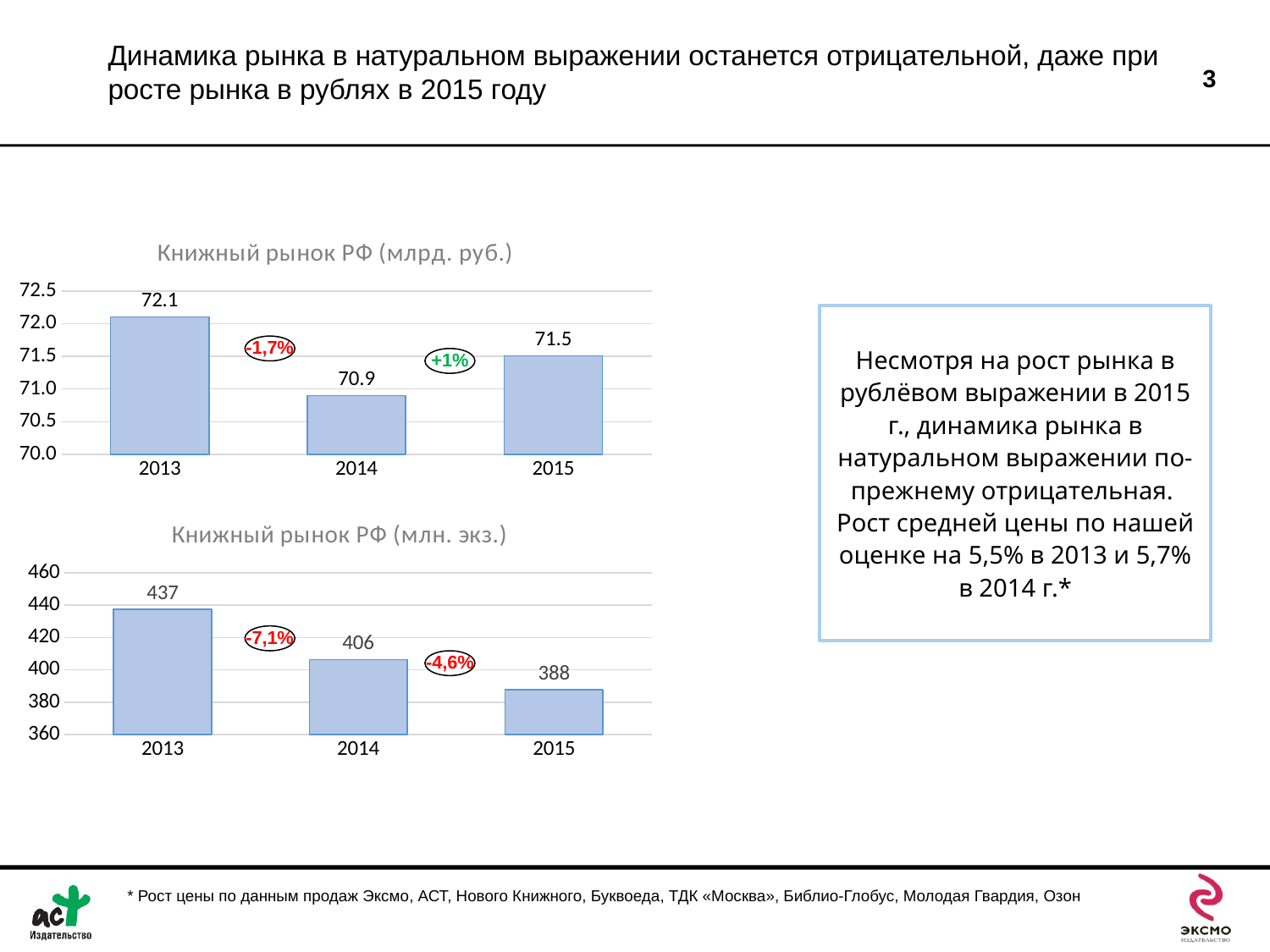
What kind of chart is the top chart on the slide? bar chart In the chart titled 'Книжный рынок РФ (млрд. руб.)', what is the difference between the 2013 and 2014 values? 1.2 In the chart titled 'Книжный рынок РФ (млрд. руб.)', what is the value for 2014? 70.9 In the chart titled 'Книжный рынок РФ (млрд. руб.)', which year has the lowest value? 2014 In the chart titled 'Книжный рынок РФ (млн. экз.)', which year has the lowest value? 2015 In the chart titled 'Книжный рынок РФ (млн. экз.)', what is the difference between the 2013 and 2015 values? 49 In the chart titled 'Книжный рынок РФ (млрд. руб.)', which year has the highest value? 2013 In the chart titled 'Книжный рынок РФ (млн. экз.)', what is the value for 2013? 437 In the chart titled 'Книжный рынок РФ (млн. экз.)', what is the value for 2015? 388 In the chart titled 'Книжный рынок РФ (млрд. руб.)', how many bars are plotted? 3 In the chart titled 'Книжный рынок РФ (млн. экз.)', is the value for 2014 larger or smaller than the value for 2015? larger In the chart titled 'Книжный рынок РФ (млн. экз.)', do the values rise or fall from 2013 to 2015? fall